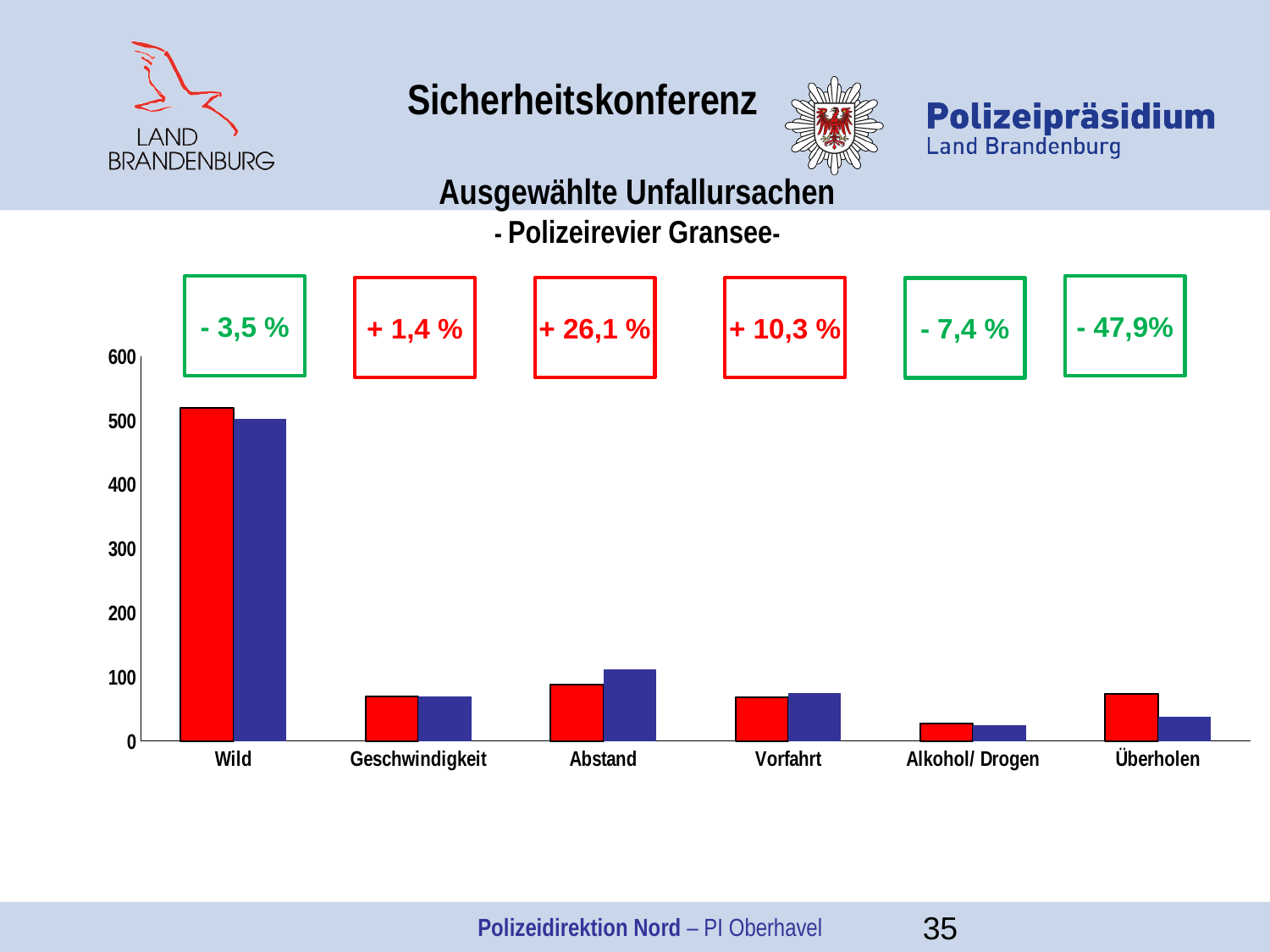
Which category has the highest bars in the chart? Wild Is the value of the blue bar for Abstand greater or less than 100? greater What is the subtitle of the chart below 'Ausgewählte Unfallursachen'? - Polizeirevier Gransee- Which category has the lowest bars in the chart? Alkohol/ Drogen For Überholen, which bar is larger, the red one or the blue one? the red one How many accident-cause categories are shown on the x axis of the chart? 6 What kind of chart is shown on the slide? bar chart Is the value of the blue bar for Überholen greater or less than 100? less For Abstand, which bar is larger, the red one or the blue one? the blue one What percentage change is shown in the box above the Überholen category? - 47,9% What percentage change is shown in the box above the Abstand category? + 26,1 % Is the value of the red bar for Wild greater or less than 400? greater